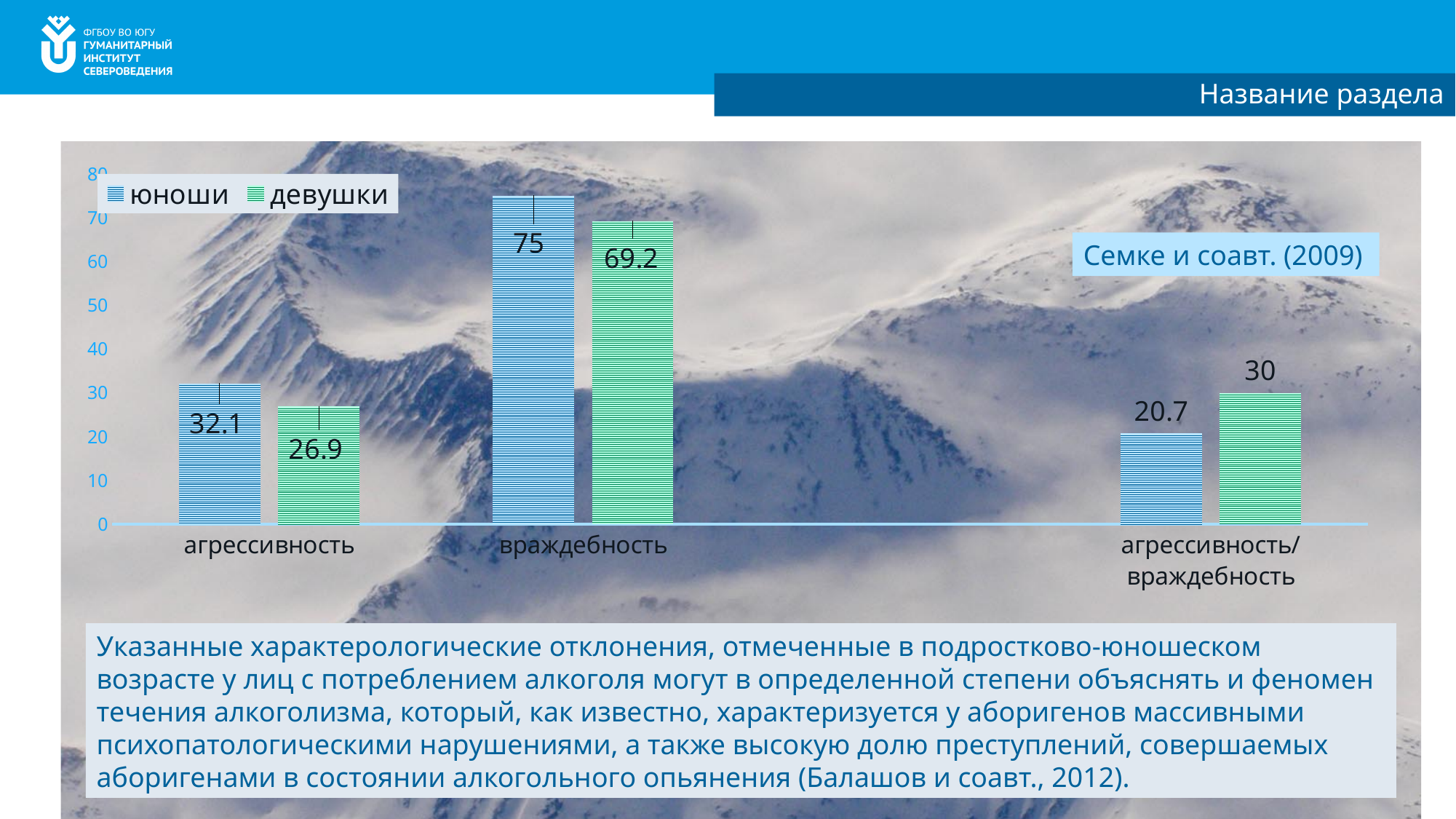
Which is larger in the агрессивность/враждебность category: the value for юноши or for девушки? девушки In which category is the value for юноши the highest? враждебность What is the value for девушки in the враждебность category? 69.2 What is the value for девушки in the агрессивность category? 26.9 In which category is the value for девушки the lowest? агрессивность What is the value for юноши in the агрессивность/враждебность category? 20.7 What kind of chart is shown on the slide? bar chart What is the difference between the юноши and девушки values in the враждебность category? 5.8 How many categories are shown on the x axis? 3 How many series does the legend list? 2 What is the value for юноши in the агрессивность category? 32.1 Is the value for девушки in the враждебность category greater or less than 60? greater